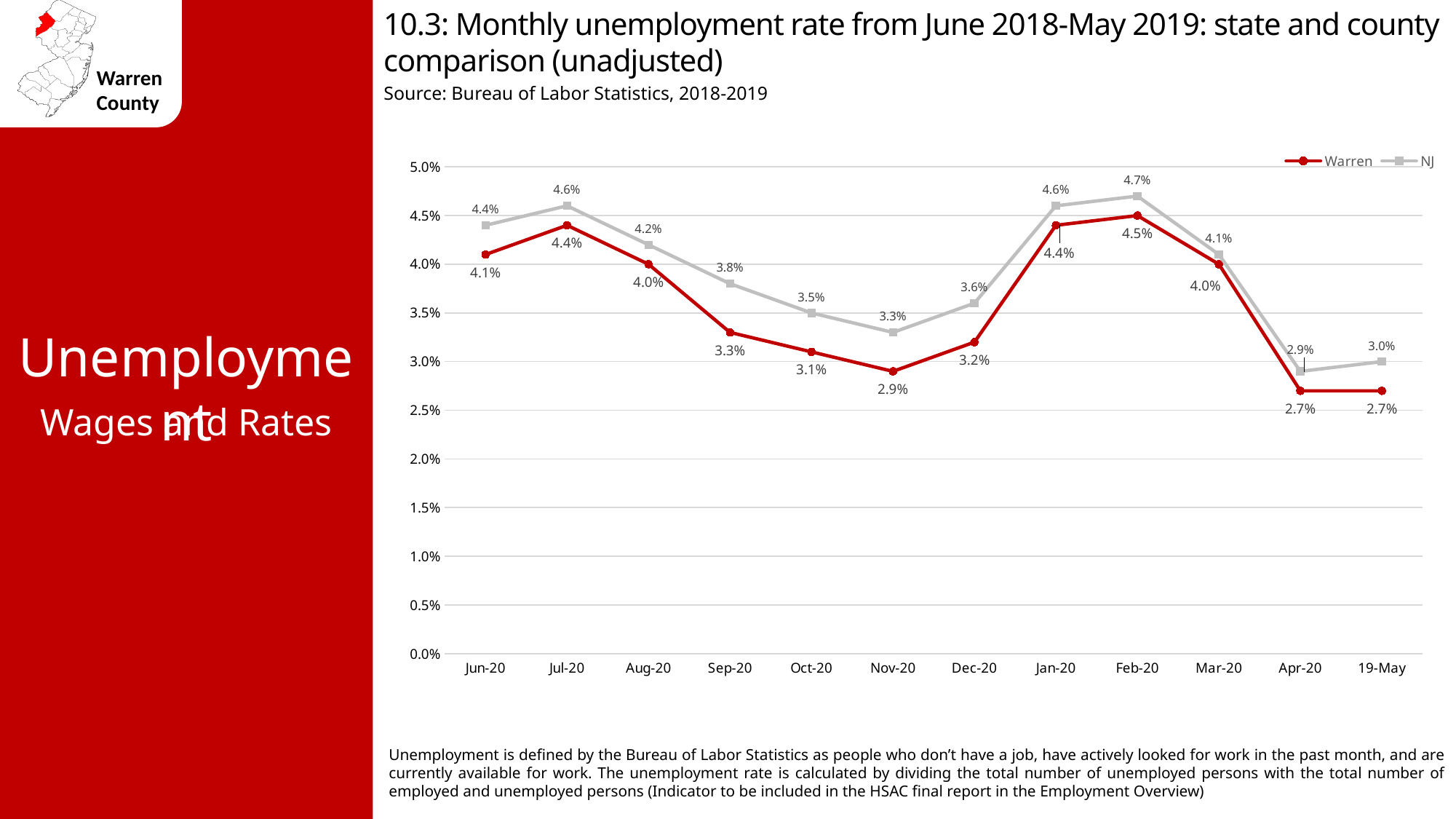
In which month does the NJ series reach its highest value? Feb-20 Does the Warren series rise or fall from Feb-20 to Apr-20? fall What is the Warren unemployment rate for Nov-20? 2.9% What is the Warren unemployment rate for Sep-20? 3.3% How many series does the legend list? 2 What is the difference between the NJ and Warren rates in Sep-20? 0.5% Which series has the higher value in Jan-20, Warren or NJ? NJ How many months are plotted on the x axis? 12 Which series is drawn in red? Warren In which month does the Warren series reach its lowest value? Apr-20 and 19-May (both 2.7%) What is the NJ unemployment rate for Feb-20? 4.7% What type of chart is shown on the slide? line chart